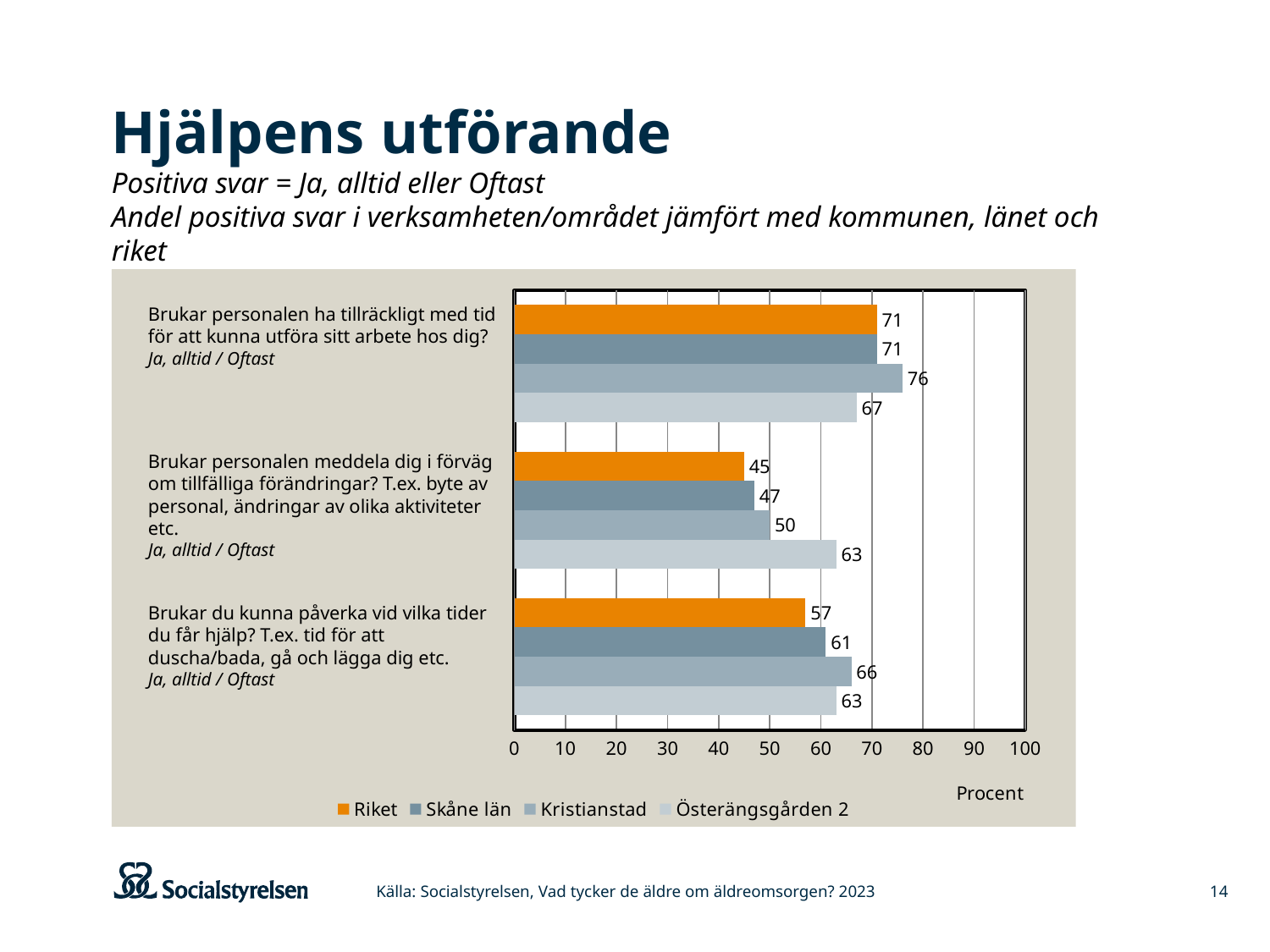
Is the value for Riket on the question 'Brukar personalen meddela dig i förväg om tillfälliga förändringar?' greater or less than 50? less Which series has the lowest value on the question 'Brukar personalen ha tillräckligt med tid för att kunna utföra sitt arbete hos dig?' Österängsgården 2 What is the value for Österängsgården 2 on the question 'Brukar personalen meddela dig i förväg om tillfälliga förändringar?' 63 What is the difference between Österängsgården 2 and Riket on the question 'Brukar personalen meddela dig i förväg om tillfälliga förändringar?' 18 Which series has the highest value on the question 'Brukar personalen meddela dig i förväg om tillfälliga förändringar?' Österängsgården 2 What is the value for Riket on the question 'Brukar du kunna påverka vid vilka tider du får hjälp?' 57 How many series does the legend list? 4 Which colour represents Riket in the chart? orange What kind of chart is shown on the slide? bar chart What is the value for Kristianstad on the question 'Brukar personalen ha tillräckligt med tid för att kunna utföra sitt arbete hos dig?' 76 On the question 'Brukar du kunna påverka vid vilka tider du får hjälp?', which is larger: Kristianstad or Österängsgården 2? Kristianstad How many question categories are plotted in the chart? 3